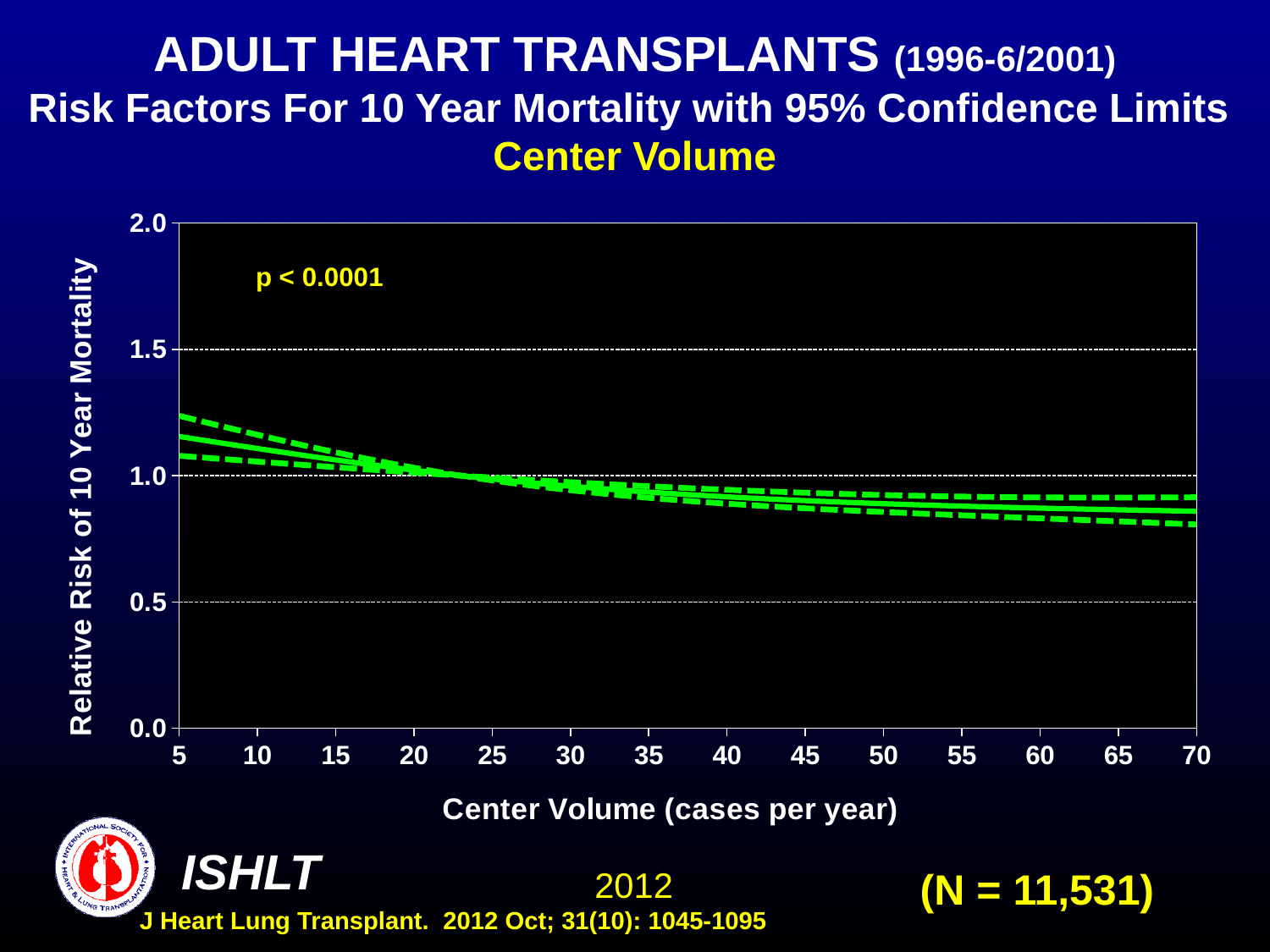
What is the highest value shown on the y axis of the chart? 2.0 Is the upper 95% confidence limit at a center volume of 5 cases per year greater or less than 1.5? less As center volume increases along the x axis, does the relative risk of 10 year mortality rise or fall? Fall What kind of chart is shown on the slide? Line chart How many lines are plotted on the chart (the estimate plus its confidence limits)? 3 What is the label of the x axis of the chart? Center Volume (cases per year) What p-value is printed on the chart? p < 0.0001 Is the relative risk of 10 year mortality at a center volume of 5 cases per year greater or less than 1.0? greater Which has the higher relative risk of 10 year mortality: a center volume of 10 or a center volume of 60 cases per year? 10 Is the relative risk of 10 year mortality at a center volume of 70 cases per year greater or less than 1.0? less What is the sample size N shown on the slide? N = 11,531